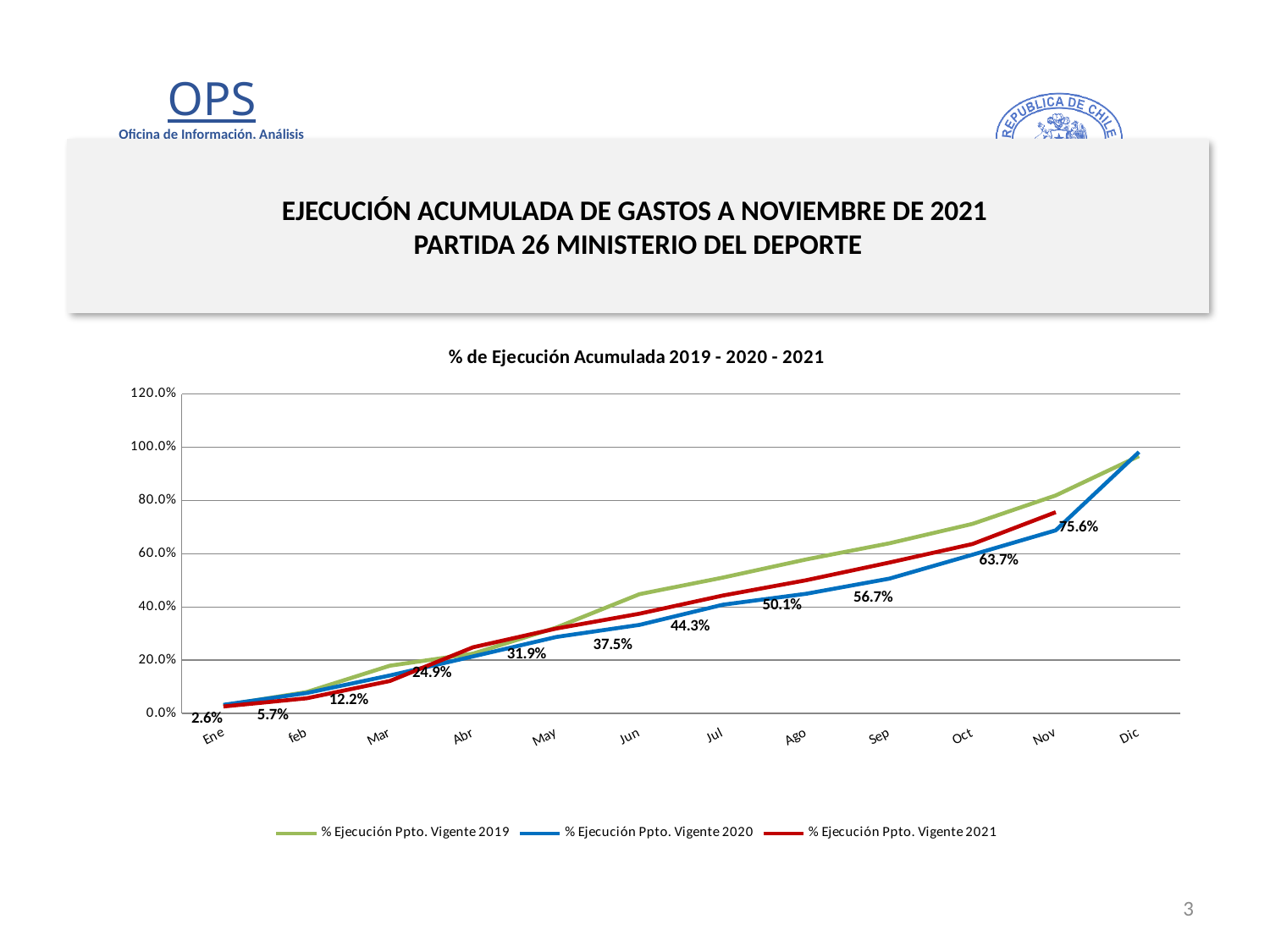
What is the value of % Ejecución Ppto. Vigente 2021 for Jun? 37.5% Which month has the lowest value for % Ejecución Ppto. Vigente 2021? Ene What is the difference between the % Ejecución Ppto. Vigente 2021 values for Nov and Oct? 11.9% What is the value of % Ejecución Ppto. Vigente 2021 for Nov? 75.6% What is the value of % Ejecución Ppto. Vigente 2021 for Sep? 56.7% Which month has the highest value for % Ejecución Ppto. Vigente 2021? Nov What kind of chart is shown on the slide? Line chart What is the value of % Ejecución Ppto. Vigente 2021 for Ene? 2.6% Which series is higher in Oct, % Ejecución Ppto. Vigente 2019 or % Ejecución Ppto. Vigente 2020? % Ejecución Ppto. Vigente 2019 How many series does the legend list? 3 Do the values of % Ejecución Ppto. Vigente 2021 rise or fall from Ene to Nov? Rise Is the value of % Ejecución Ppto. Vigente 2019 for Dic greater or less than 80.0%? greater